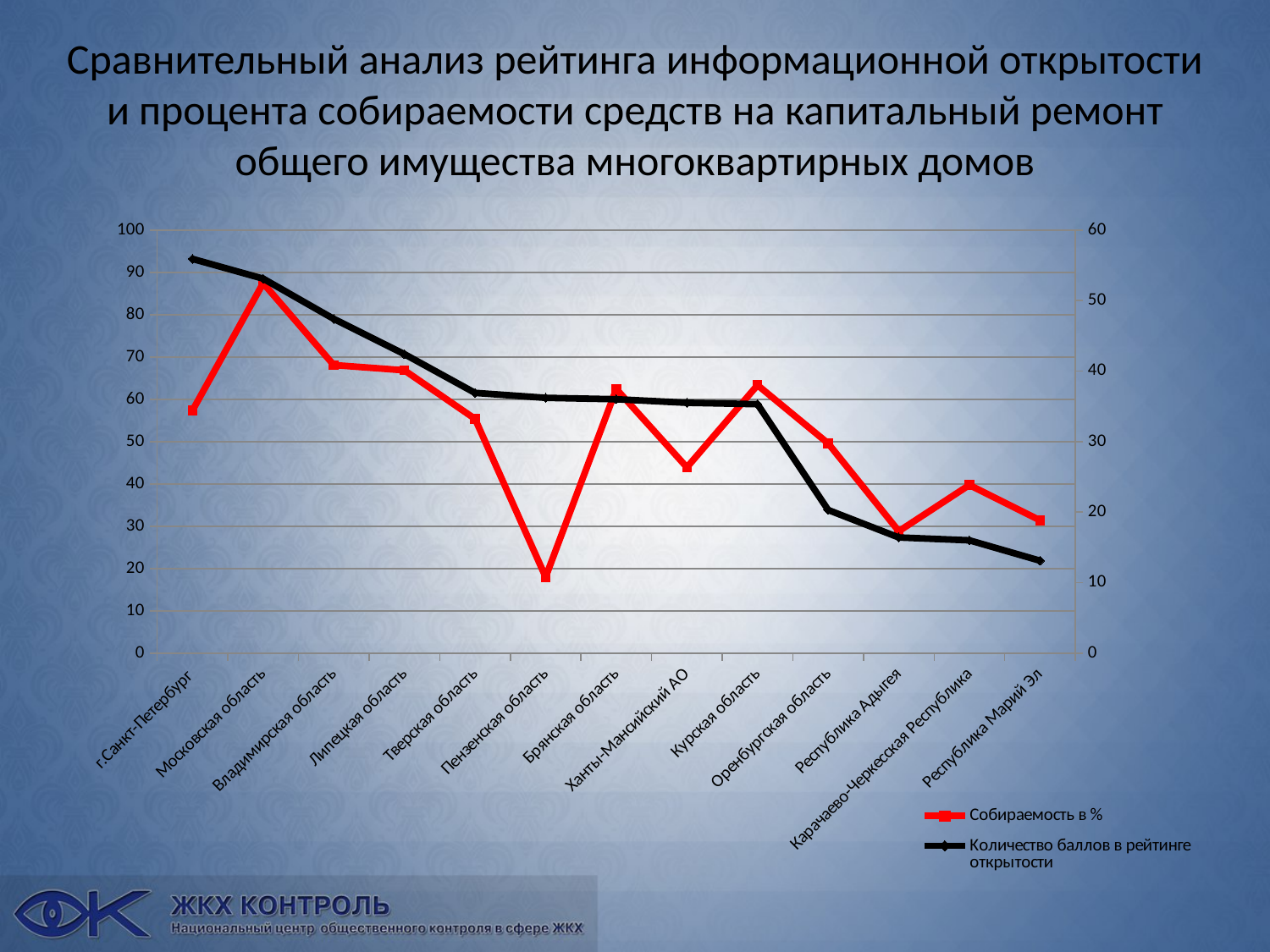
Which region has the highest value for Количество баллов в рейтинге открытости? г.Санкт-Петербург Which region has the highest value for Собираемость в %? Московская область Which region has the lowest value for Количество баллов в рейтинге открытости? Республика Марий Эл Is the Собираемость в % value for Московская область greater or less than 80? greater How many series does the legend list? 2 Does the Количество баллов в рейтинге открытости line generally rise or fall from left to right? fall Is the Собираемость в % value for Пензенская область greater or less than 30? less What colour is the line for Собираемость в %? red What kind of chart is shown on the slide? line chart Which region has the lowest value for Собираемость в %? Пензенская область How many regions are plotted along the x axis? 13 Which has the larger Собираемость в % value, Брянская область or Ханты-Мансийский АО? Брянская область